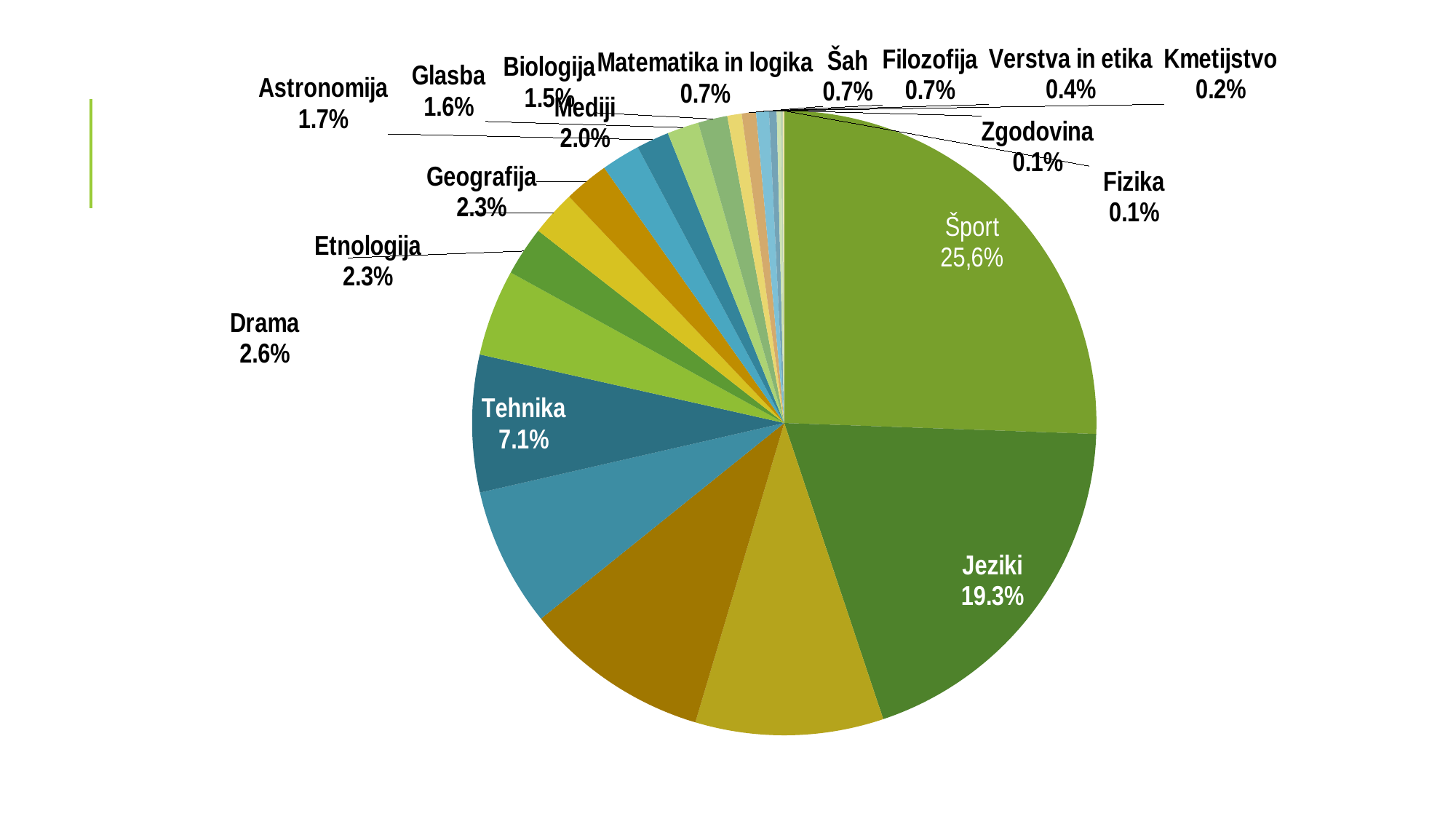
What is the value shown for Jeziki? 19.3% What is the value shown for Verstva in etika? 0.4% What is the value shown for Tehnika? 7.1% What is the value shown for Mediji? 2.0% Which is larger, the share for Drama or the share for Mediji? Drama What is the value shown for Kmetijstvo? 0.2% What type of chart is shown on the slide? pie chart Which labelled category has the largest share of the pie? Šport What is the difference between the shares for Jeziki and Tehnika? 12.2% What share of the pie does Šport have? 25,6% What is the value shown for Drama? 2.6% Which is larger, the share for Astronomija or the share for Glasba? Astronomija